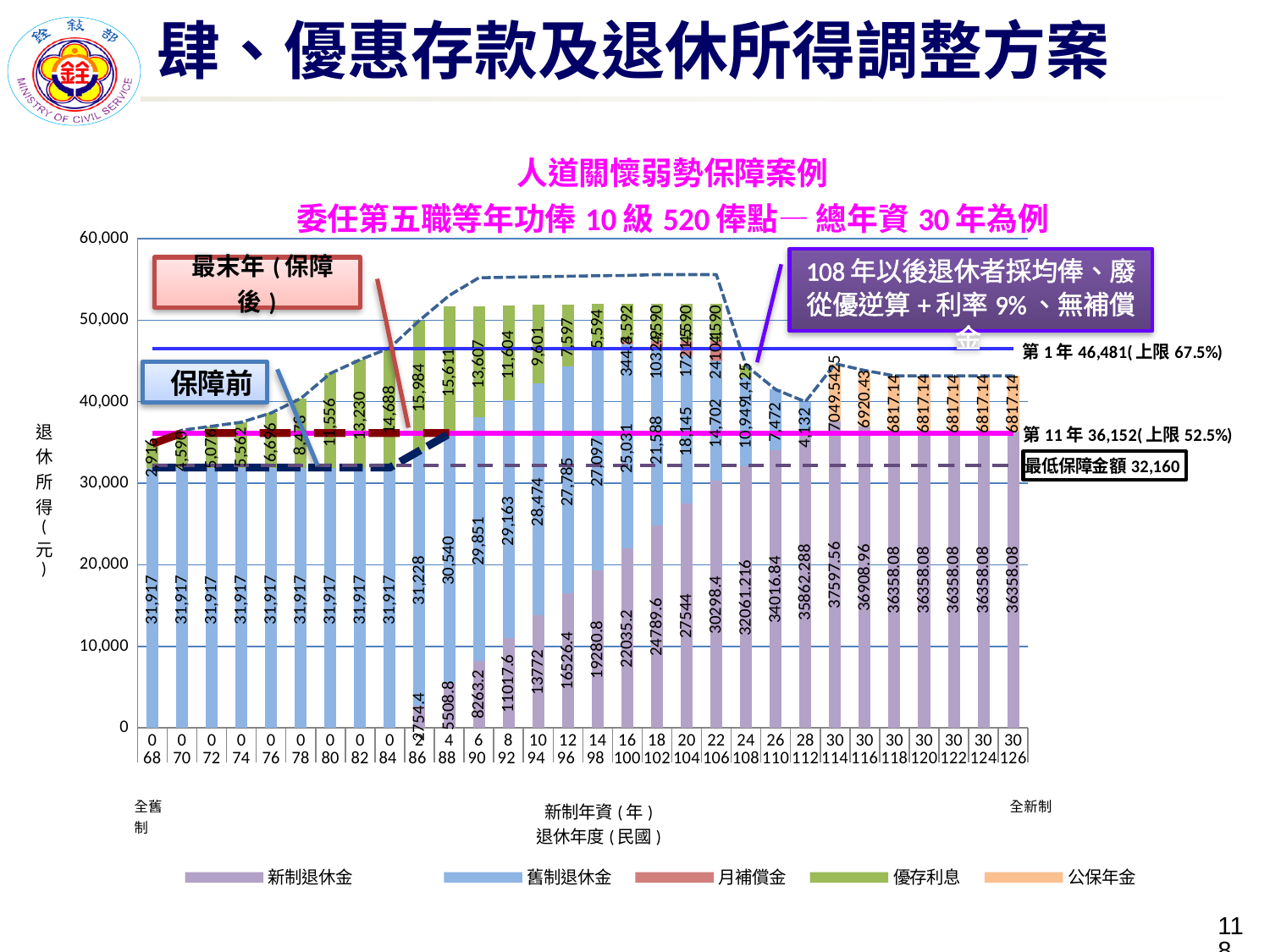
What kind of chart is shown on the slide? combination stacked bar and line chart What is the 公保年金 value for retirement year 114? 7049.54 What is the 新制退休金 value for retirement year 126? 36358.08 How many series does the legend list? 5 What is the difference between the 舊制退休金 value for retirement year 68 and for retirement year 86? 689 What is the 優存利息 value for retirement year 86? 15,984 How many retirement-year categories are shown on the x axis? 30 What value is shown for the 最低保障金額 line? 32,160 What is the 舊制退休金 value for retirement year 112? 4,132 What is the 舊制退休金 value for retirement year 68? 31,917 Does the 新制退休金 value rise or fall from retirement year 86 to retirement year 114? rise Which is larger, the 優存利息 value for retirement year 84 or for retirement year 78? retirement year 84